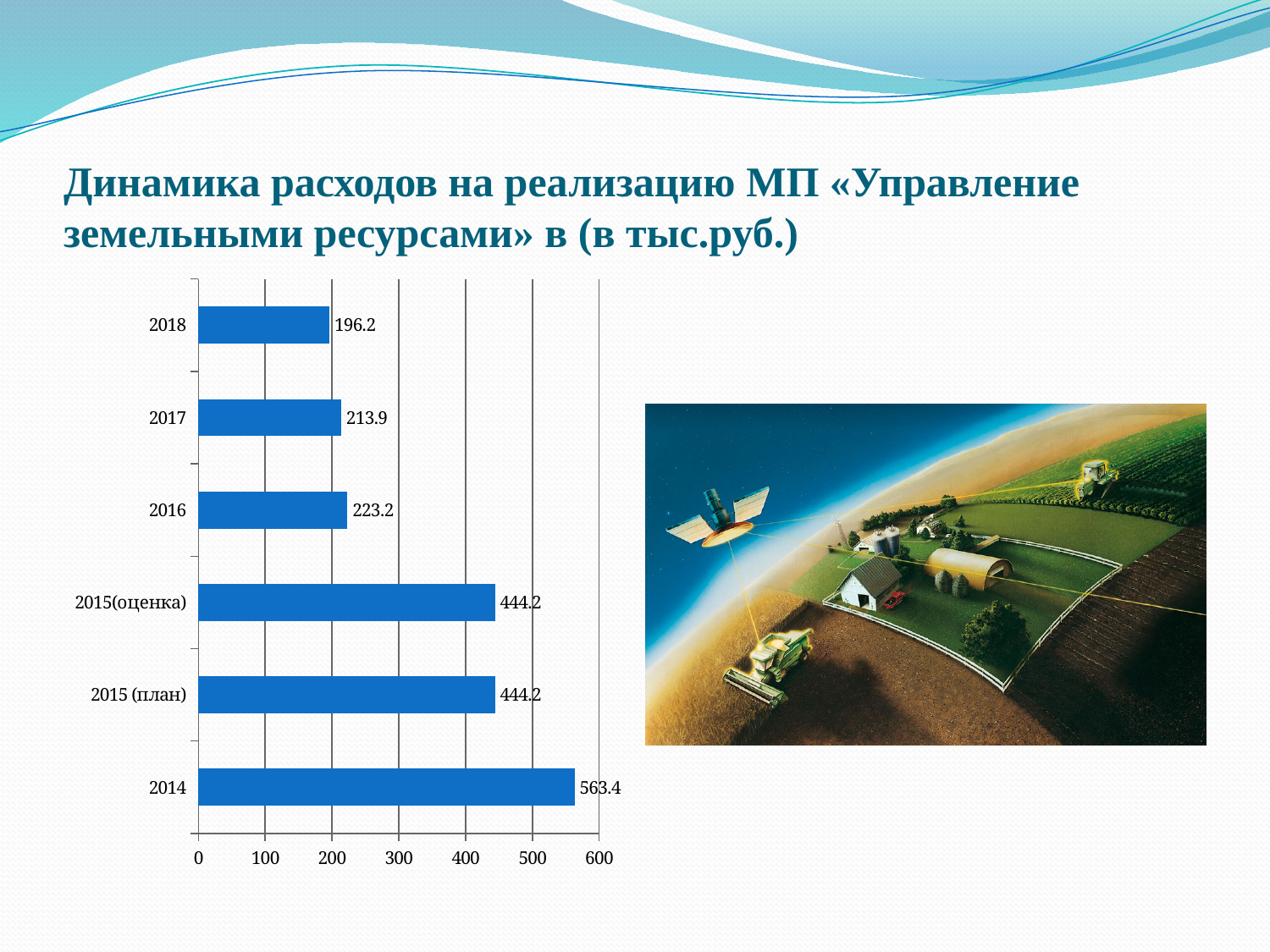
What is the value for 2014? 563.4 What is the difference between the values for 2016 and 2017? 9.3 What is the difference between the values for 2014 and 2018? 367.2 What kind of chart is shown on the slide? bar chart Which category has the lowest value? 2018 What is the value for 2016? 223.2 What is the unit of measurement stated in the chart title? тыс.руб. What is the value for 2018? 196.2 How many categories are shown on the chart? 6 Which category has the highest value? 2014 What is the value for 2015 (план)? 444.2 Which is larger, the value for 2017 or the value for 2016? 2016